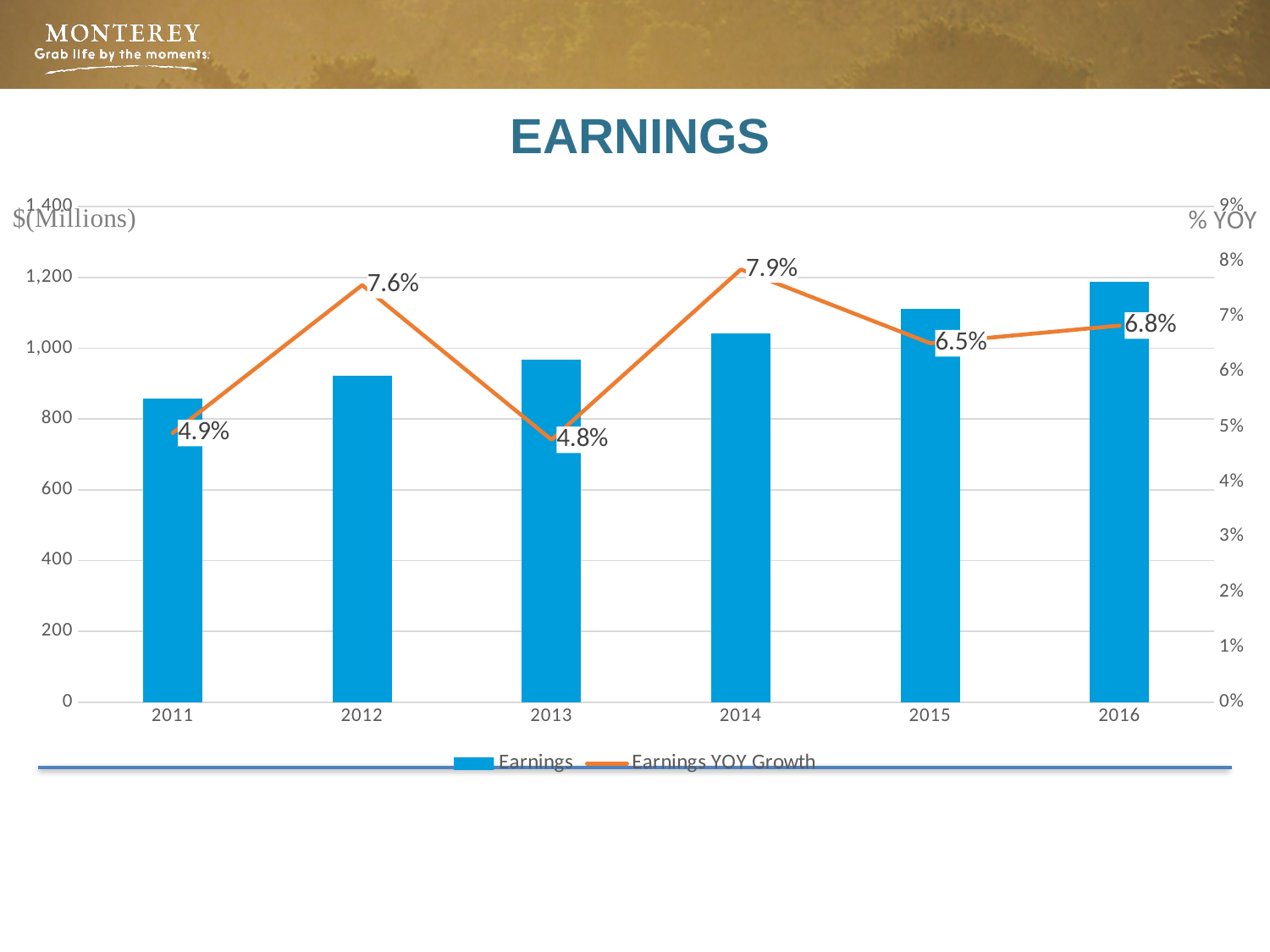
What is the Earnings YOY Growth value for 2016? 6.8% Which year has the highest Earnings bar? 2016 How many series does the legend list? 2 What is the Earnings YOY Growth value for 2014? 7.9% Is the Earnings value for 2016 greater or less than 1,000? greater What is the Earnings YOY Growth value for 2011? 4.9% Which is larger, the Earnings YOY Growth in 2015 or in 2016? 2016 Which year has the lowest Earnings YOY Growth? 2013 How many years are shown on the x axis? 6 Is the Earnings value for 2011 greater or less than 1,000? less What is the difference between the Earnings YOY Growth in 2012 and in 2013? 2.8% Which year has the highest Earnings YOY Growth? 2014